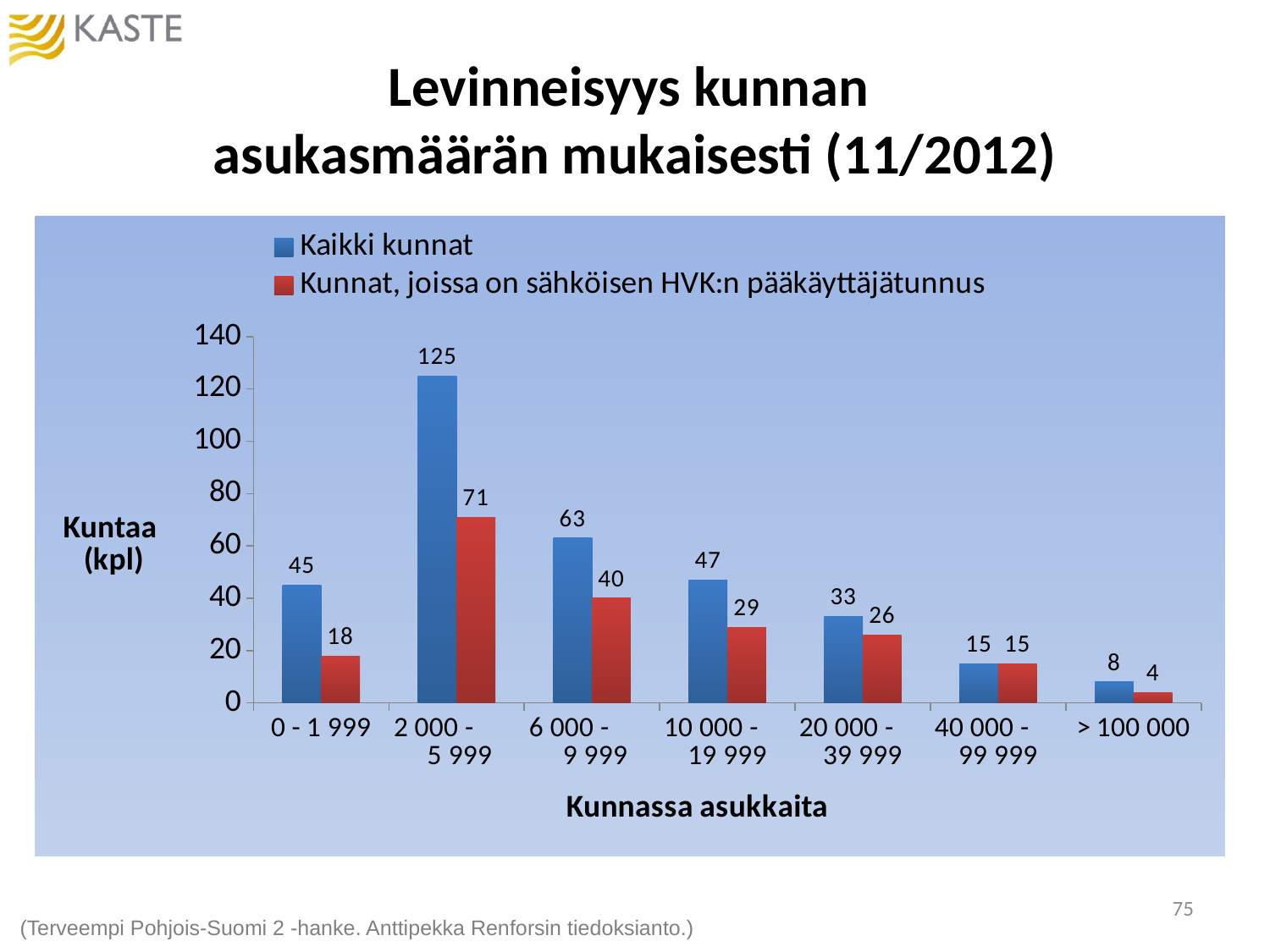
How many categories are shown on the x axis? 7 How many series does the legend list? 2 What is the value for 'Kunnat, joissa on sähköisen HVK:n pääkäyttäjätunnus' in the '0 - 1 999' category? 18 What is the value for 'Kaikki kunnat' in the '> 100 000' category? 8 What is the value for 'Kaikki kunnat' in the '2 000 - 5 999' category? 125 What is the difference between 'Kaikki kunnat' and 'Kunnat, joissa on sähköisen HVK:n pääkäyttäjätunnus' in the '6 000 - 9 999' category? 23 What is the label of the y axis? Kuntaa (kpl) What kind of chart is shown on the slide? Bar chart Which category has the highest value for 'Kaikki kunnat'? 2 000 - 5 999 Which category has the lowest value for 'Kunnat, joissa on sähköisen HVK:n pääkäyttäjätunnus'? > 100 000 Do the values for 'Kaikki kunnat' rise or fall from the '2 000 - 5 999' category to the '> 100 000' category? Fall Which is larger in the '10 000 - 19 999' category: 'Kaikki kunnat' or 'Kunnat, joissa on sähköisen HVK:n pääkäyttäjätunnus'? Kaikki kunnat